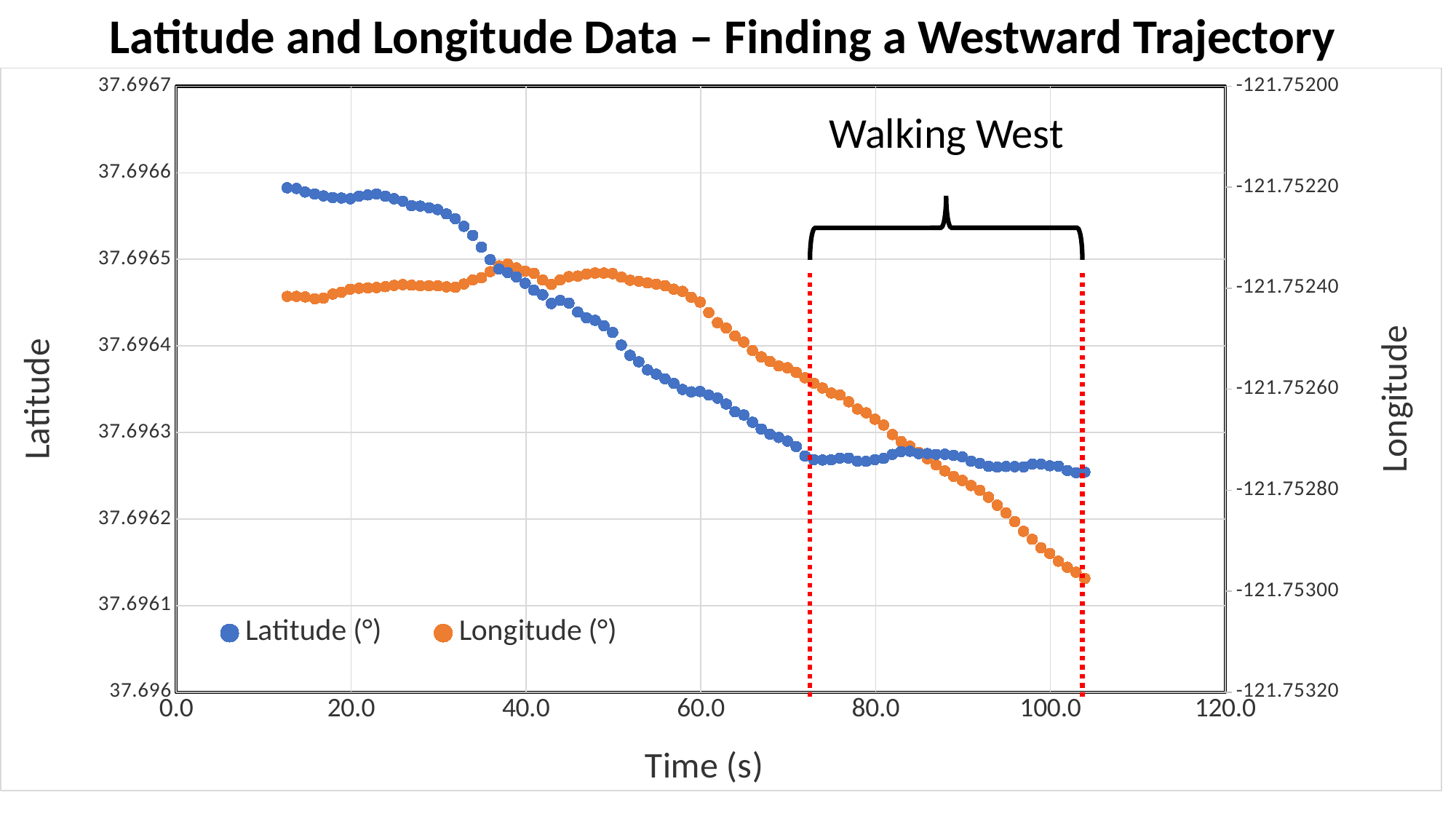
Does the Latitude (°) series generally rise or fall as time increases? Fall Is the Latitude (°) value at 100 s greater or less than 37.6963? less What kind of chart is shown on the slide? Scatter chart Is the Longitude (°) value at 100 s greater or less than -121.75280? less Is the Latitude (°) value at 40 s greater or less than 37.6965? less What is the label of the x axis? Time (s) What text is written above the bracketed region of the chart? Walking West How many series does the legend list? 2 Does the Longitude (°) series rise or fall between 60 s and 100 s? Fall